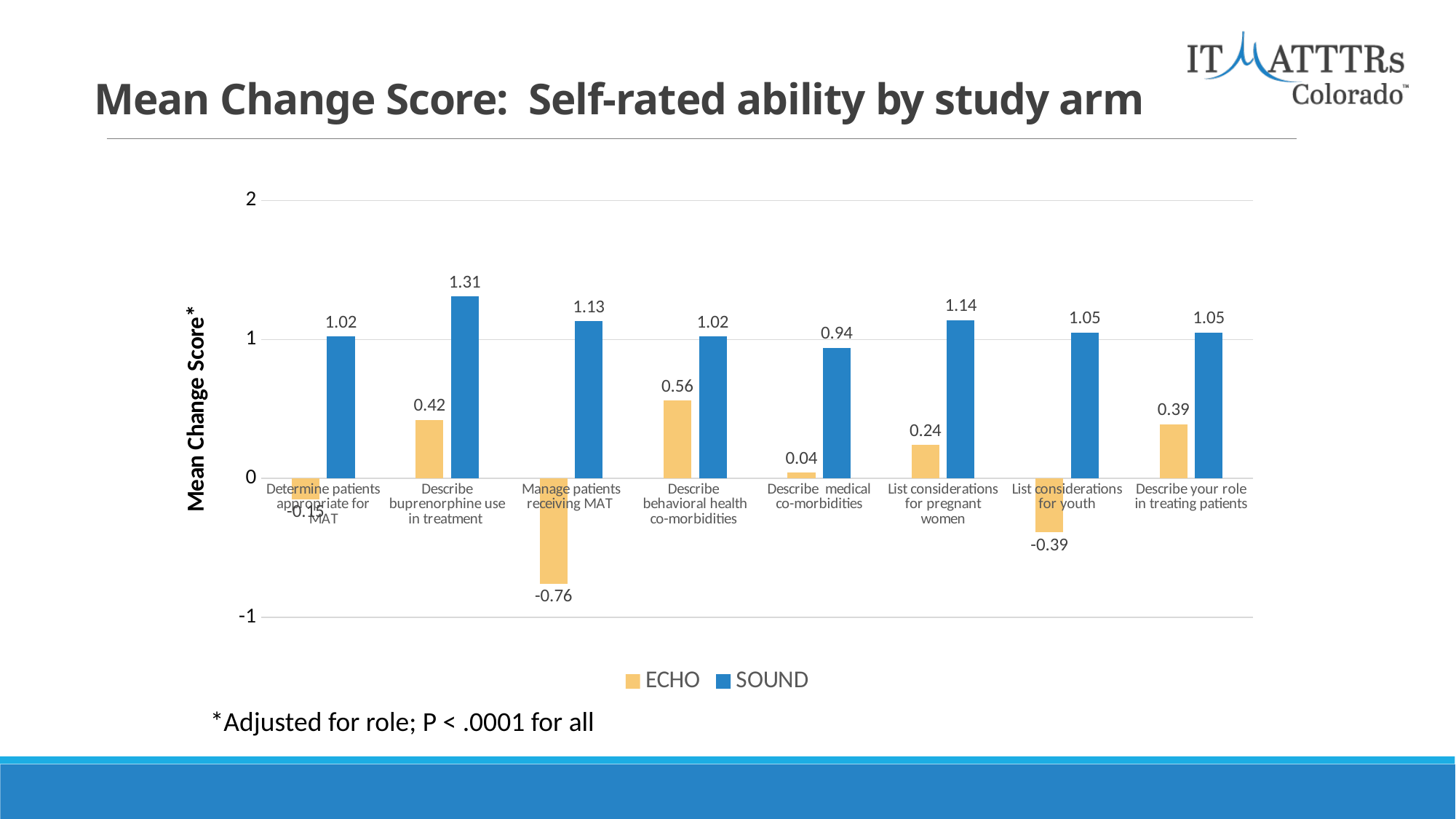
What is the SOUND mean change score for "Describe buprenorphine use in treatment"? 1.31 How many series does the legend list? 2 What is the SOUND mean change score for "Describe medical co-morbidities"? 0.94 How many categories are shown on the x axis of the chart? 8 Which category has the lowest ECHO mean change score? Manage patients receiving MAT Which category has the lowest SOUND mean change score? Describe medical co-morbidities What is the ECHO mean change score for "Manage patients receiving MAT"? -0.76 Which is larger, the ECHO score for "Describe behavioral health co-morbidities" or the ECHO score for "Describe your role in treating patients"? Describe behavioral health co-morbidities Which category has the highest SOUND mean change score? Describe buprenorphine use in treatment What is the difference between the SOUND and ECHO mean change scores for "List considerations for pregnant women"? 0.90 What is the ECHO mean change score for "Describe behavioral health co-morbidities"? 0.56 What kind of chart is shown on the slide? Bar chart